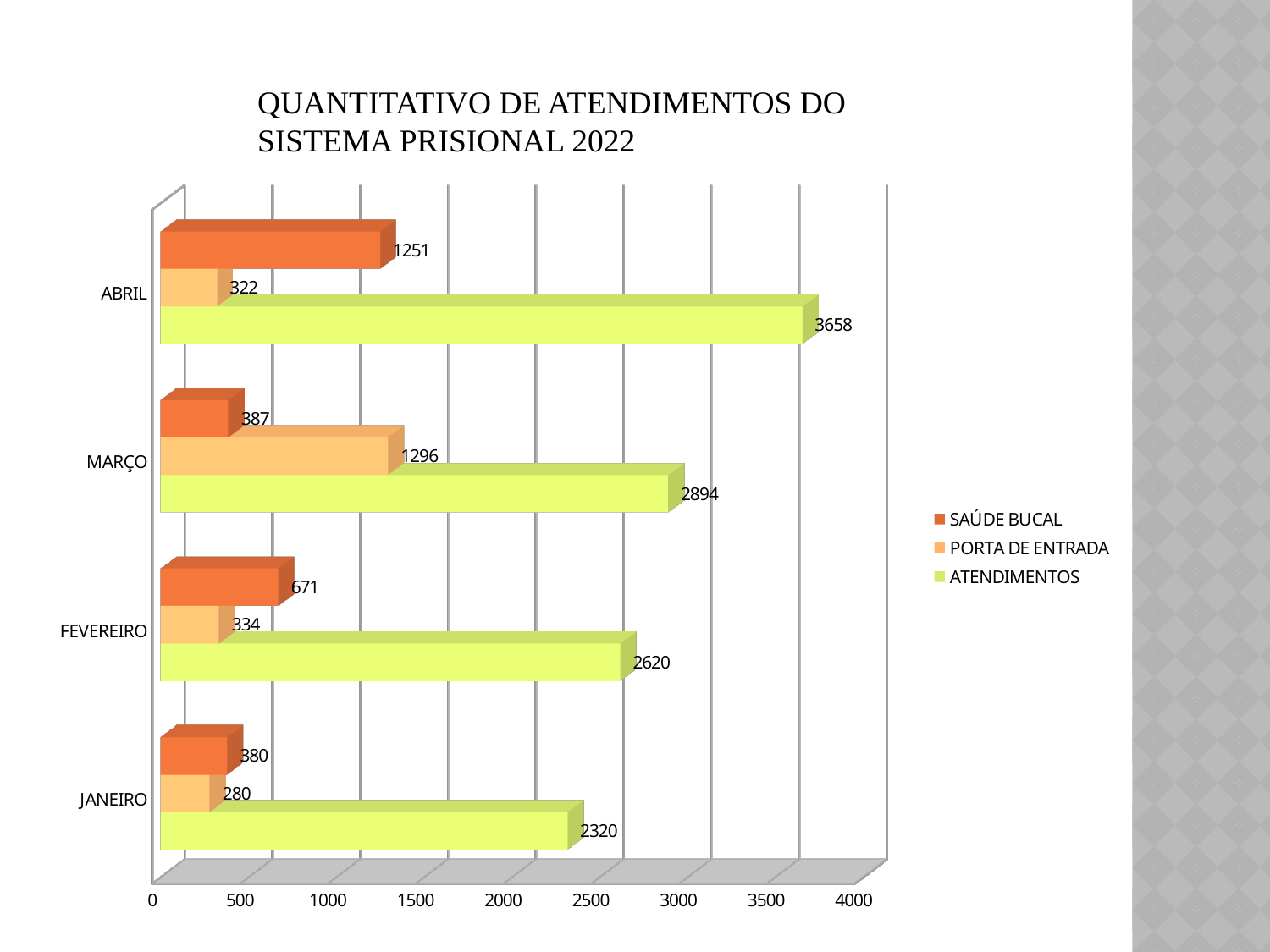
What is the ATENDIMENTOS value for ABRIL? 3658 Which month has the highest ATENDIMENTOS value? ABRIL What is the difference between the ATENDIMENTOS values for ABRIL and MARÇO? 764 Do the ATENDIMENTOS values rise or fall from JANEIRO to ABRIL? Rise What is the PORTA DE ENTRADA value for MARÇO? 1296 What is the PORTA DE ENTRADA value for JANEIRO? 280 How many series does the legend list? 3 What is the SAÚDE BUCAL value for FEVEREIRO? 671 How many months are shown on the chart? 4 Which is larger: the SAÚDE BUCAL value for MARÇO or the PORTA DE ENTRADA value for MARÇO? PORTA DE ENTRADA Which month has the lowest SAÚDE BUCAL value? JANEIRO What kind of chart is shown on the slide? Bar chart